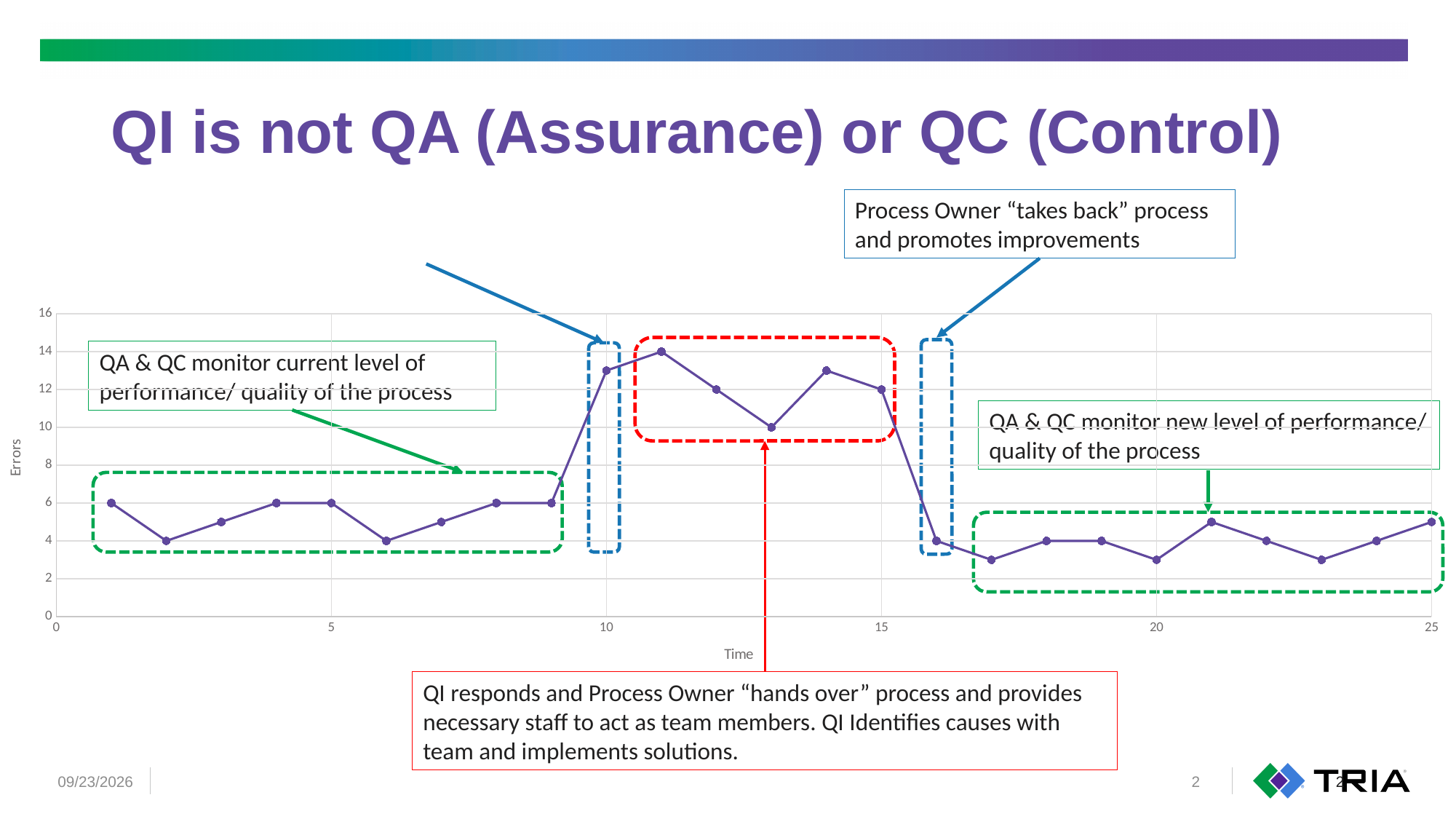
At which Time value is the number of Errors highest? 11 What is the Errors value at Time 1? 6 What is the title of the horizontal axis of the chart? Time What is the Errors value at Time 13? 10 Which has more Errors, Time 11 or Time 16? Time 11 Do the Errors values rise or fall from Time 11 to Time 13? fall Is the Errors value at Time 17 greater or less than 4? less What is the difference in Errors between Time 11 and Time 13? 4 Is the Errors value at Time 10 greater or less than 12? greater What is the title of the vertical axis of the chart? Errors What is the Errors value at Time 11? 14 What kind of chart is shown on the slide? line chart